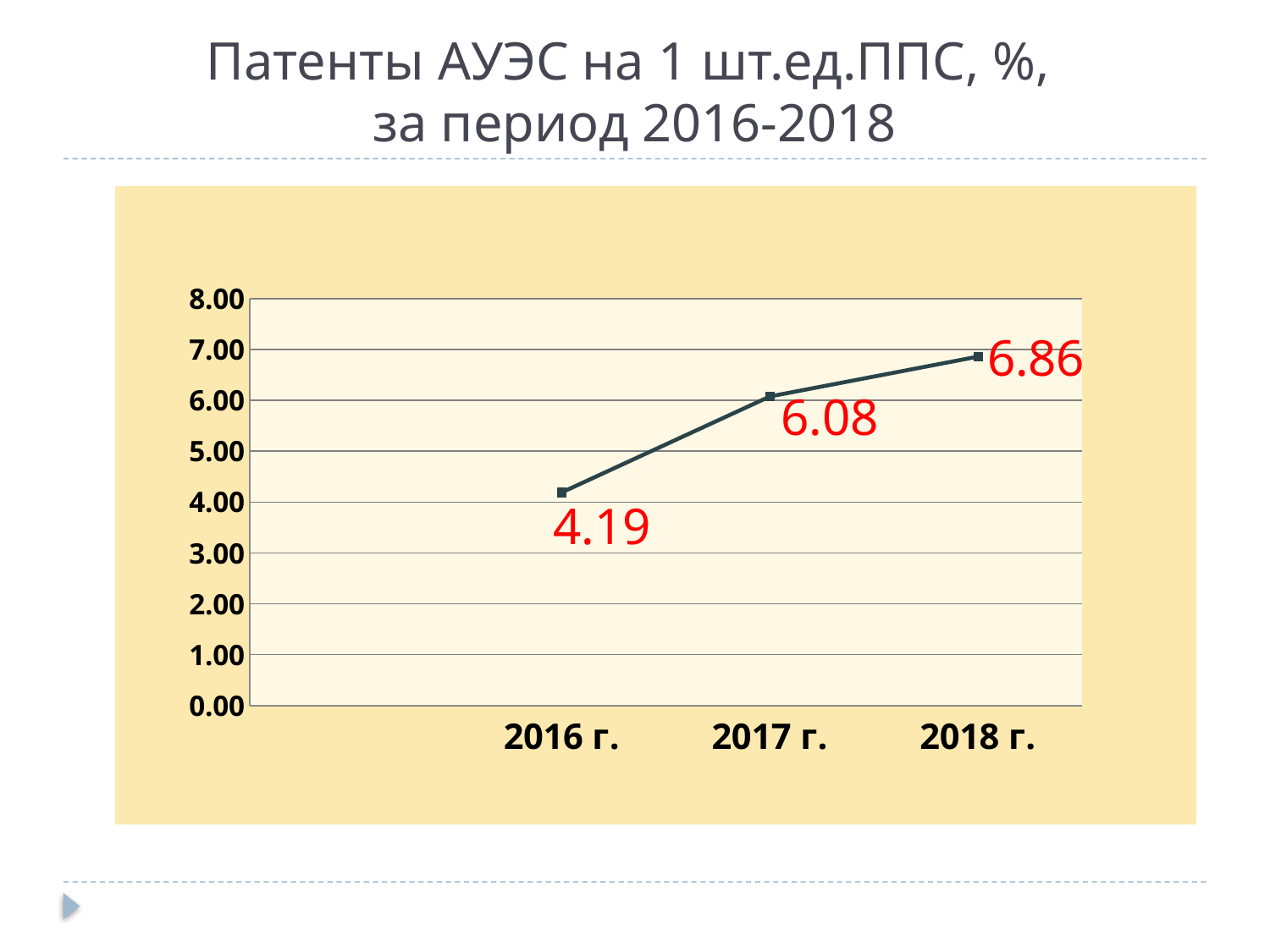
What is the difference between the values for 2018 г. and 2016 г.? 2.67 Which year has the lowest value? 2016 г. What kind of chart is shown on the slide? line chart What is the value for 2016 г.? 4.19 Which is larger, the value for 2017 г. or the value for 2018 г.? 2018 г. What is the value for 2017 г.? 6.08 Is the value for 2016 г. greater or less than 5.00? less Which year has the highest value? 2018 г. What is the difference between the values for 2017 г. and 2016 г.? 1.89 Do the values rise or fall from 2016 г. to 2018 г.? rise How many data points are plotted on the chart? 3 What is the value for 2018 г.? 6.86